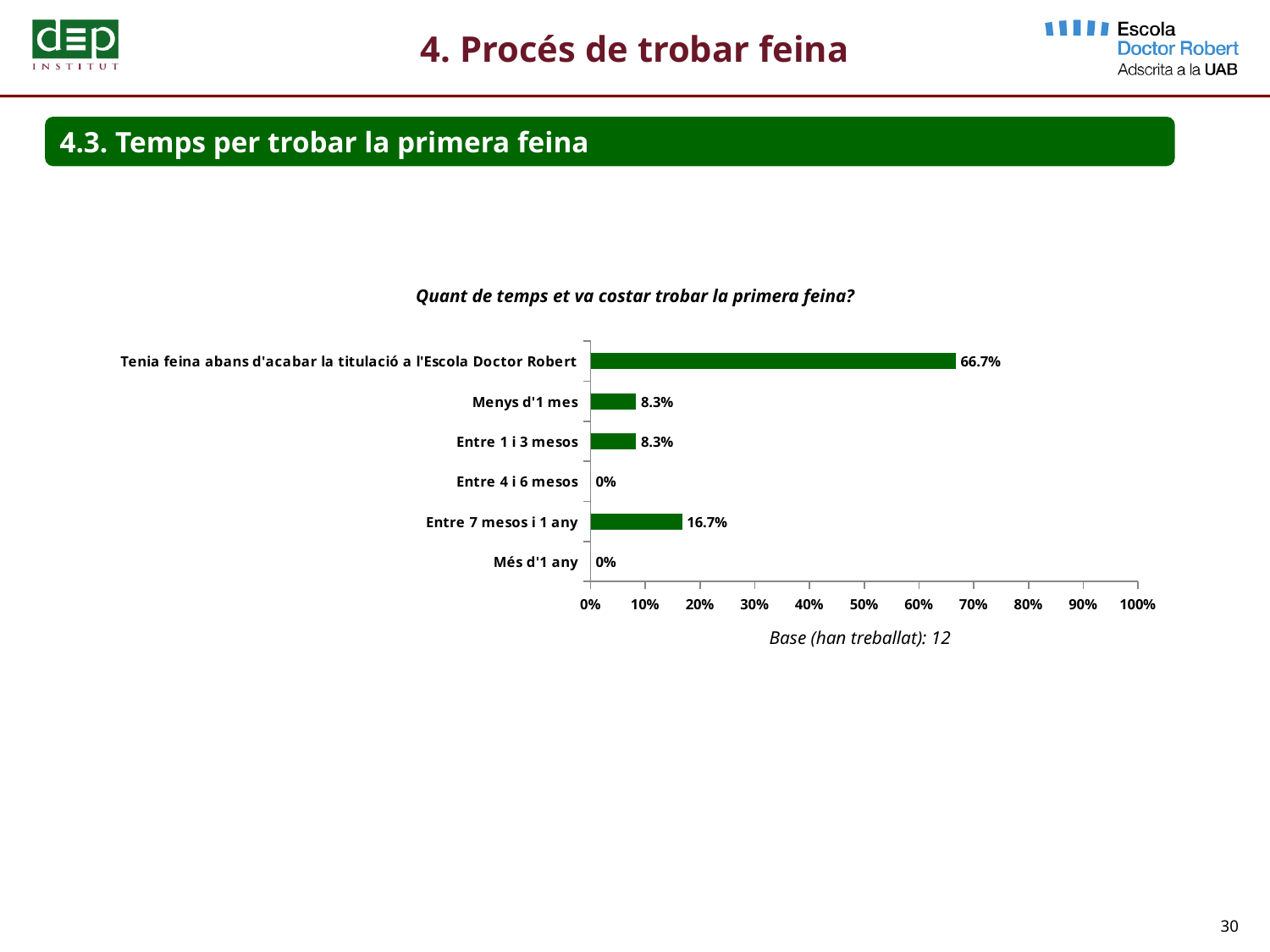
What is the value for "Tenia feina abans d'acabar la titulació a l'Escola Doctor Robert"? 66.7% What kind of chart is shown on the slide? bar chart Which is larger, the value for "Entre 7 mesos i 1 any" or the value for "Menys d'1 mes"? Entre 7 mesos i 1 any What is the difference between the values for "Tenia feina abans d'acabar la titulació a l'Escola Doctor Robert" and "Entre 7 mesos i 1 any"? 50% How many categories are shown in the chart? 6 What is the value for "Entre 7 mesos i 1 any"? 16.7% What is the value for "Menys d'1 mes"? 8.3% What is the difference between the values for "Entre 7 mesos i 1 any" and "Entre 1 i 3 mesos"? 8.4% What is the value for "Entre 4 i 6 mesos"? 0% What is the question shown as the chart's title? Quant de temps et va costar trobar la primera feina? Is the value for "Tenia feina abans d'acabar la titulació a l'Escola Doctor Robert" greater or less than 60%? greater Which category has the highest value? Tenia feina abans d'acabar la titulació a l'Escola Doctor Robert